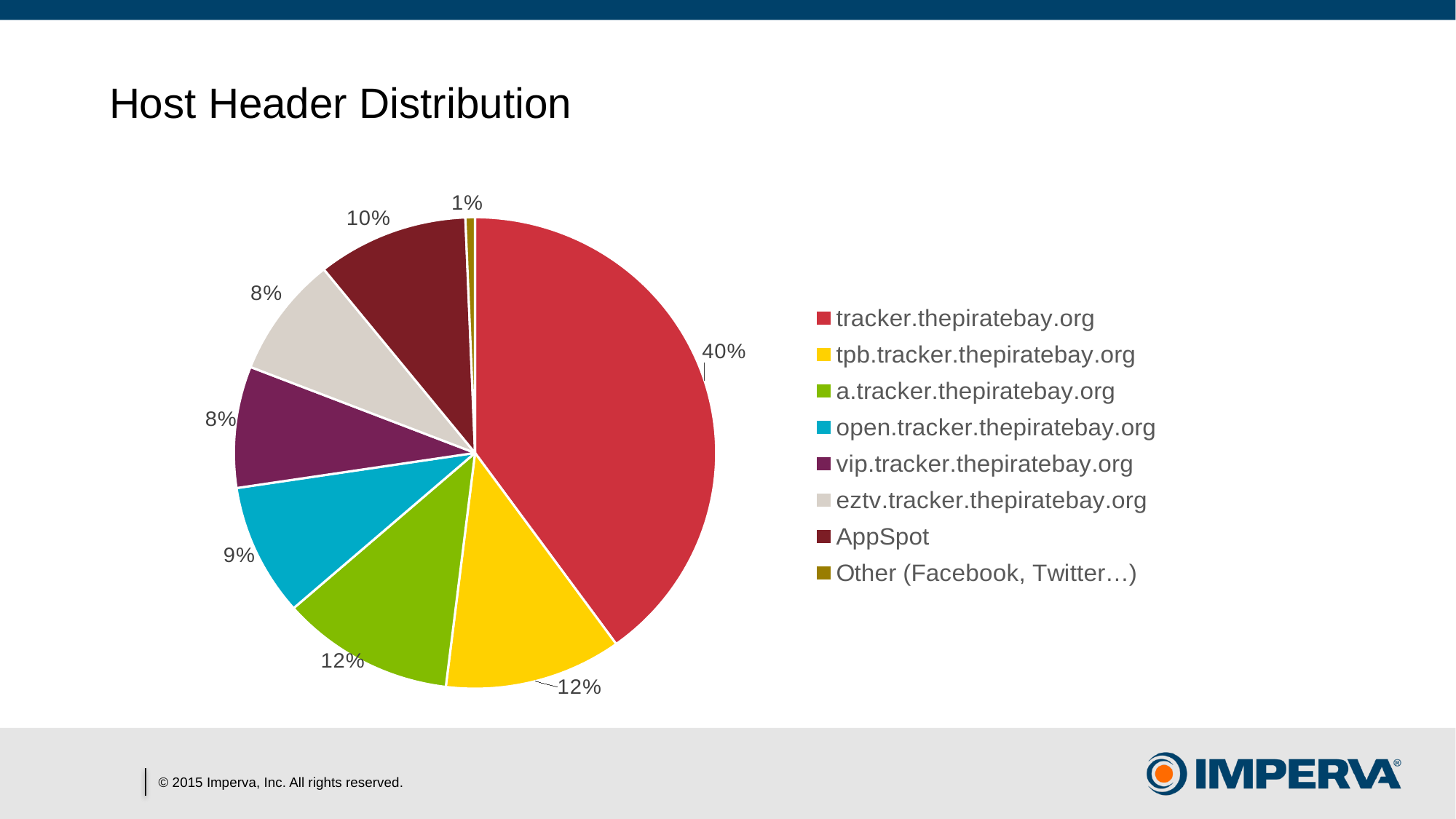
What kind of chart is shown on the slide? Pie chart What percentage is shown for Other (Facebook, Twitter…)? 1% What percentage is shown for AppSpot? 10% What share of the pie does tracker.thepiratebay.org hold? 40% What colour is the slice for tpb.tracker.thepiratebay.org? Yellow Which category has the largest slice of the pie? tracker.thepiratebay.org Which is larger, the share for AppSpot or the share for vip.tracker.thepiratebay.org? AppSpot What is the difference in percentage points between tracker.thepiratebay.org and AppSpot? 30 What percentage is shown for open.tracker.thepiratebay.org? 9% How many categories does the legend list? 8 Which category has the smallest slice of the pie? Other (Facebook, Twitter…) What is the title of the slide? Host Header Distribution